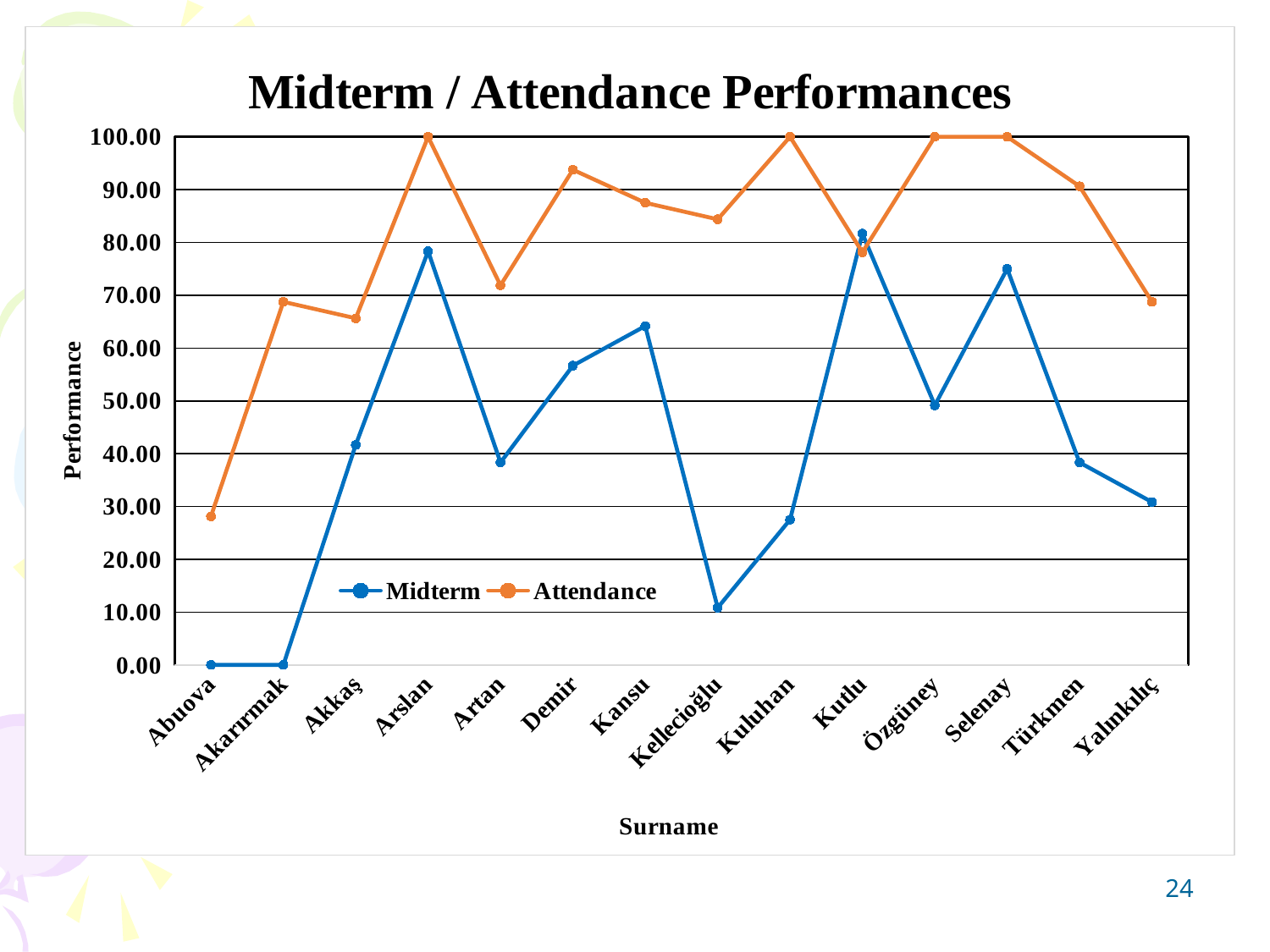
What is the title of the chart? Midterm / Attendance Performances Is the Midterm value for Kellecioğlu greater or less than 20.00? less Which surname has the lowest Attendance value? Abuova Does the Attendance line rise or fall from Selenay to Yalınkılıç? Fall What is the Attendance value for Selenay? 100.00 What is the Attendance value for Kuluhan? 100.00 What kind of chart is shown on the slide? Line chart How many series does the legend list? 2 Which is larger for Kansu, the Midterm value or the Attendance value? Attendance Is the Midterm value for Arslan greater or less than 70.00? greater How many surnames are plotted along the x axis? 14 What is the Midterm value for Abuova? 0.00